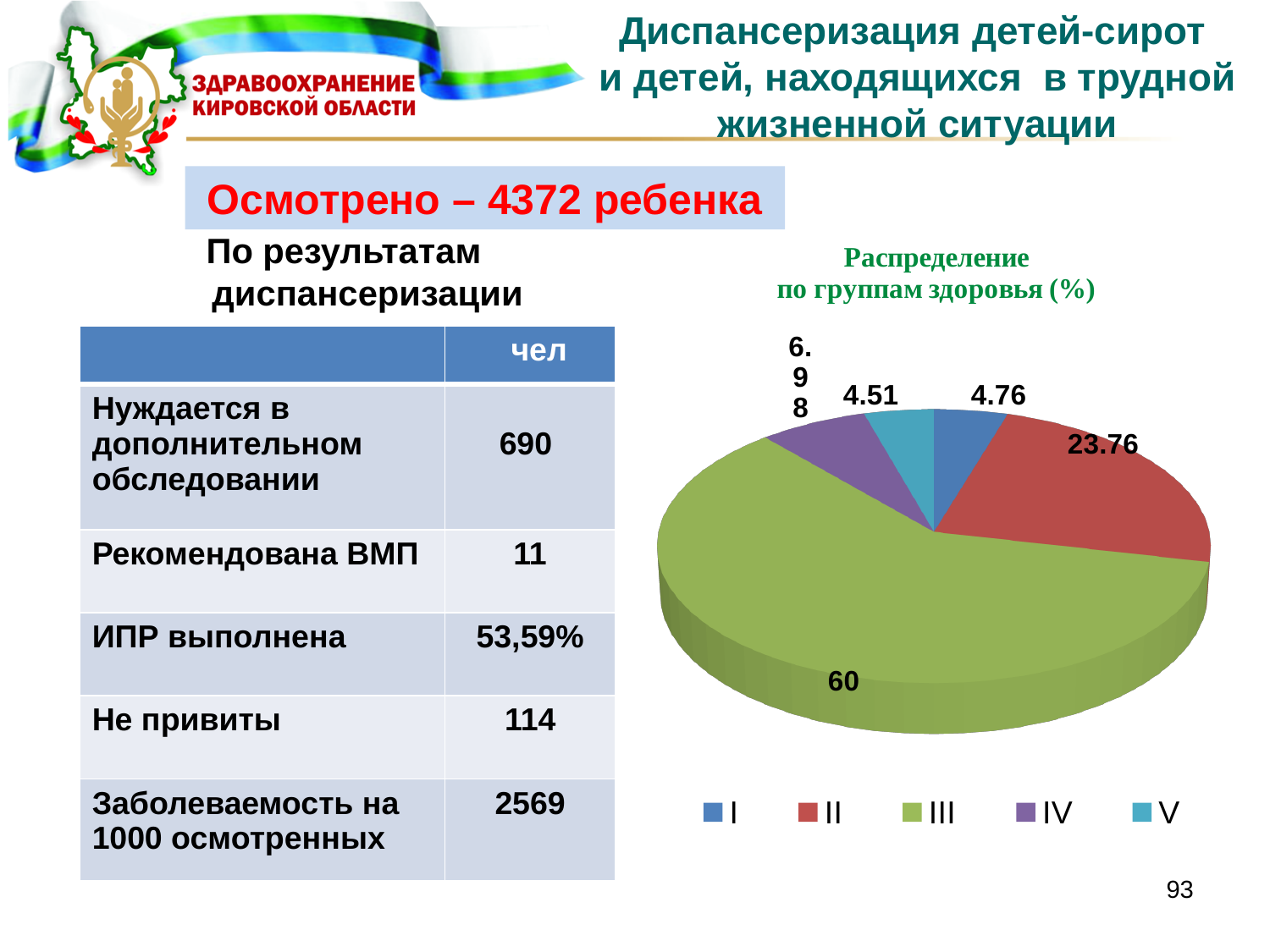
Which is larger, the value for health group IV or health group I? IV Which health group has the largest slice in the pie chart? III What is the value for health group II in the pie chart? 23.76 What is the difference between the values for health groups III and II? 36.24 What is the title of the pie chart? Распределение по группам здоровья (%) What is the value for health group IV in the pie chart? 6.98 What is the value for health group V in the pie chart? 4.51 Which health group has the smallest slice in the pie chart? V What kind of chart is shown on the slide? pie chart What is the value for health group I in the pie chart? 4.76 How many health groups are shown in the pie chart? 5 What is the value for health group III in the pie chart? 60